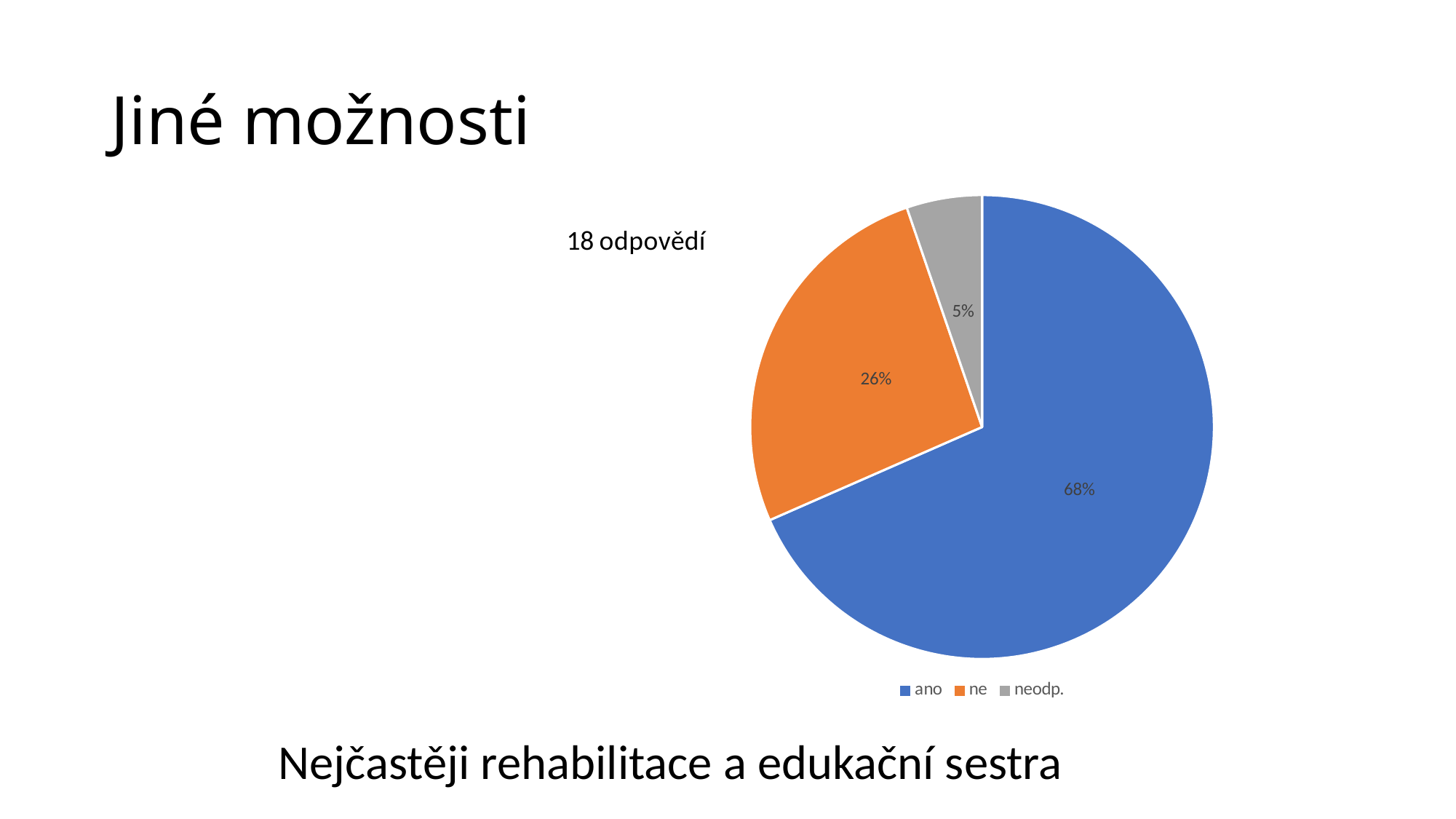
What share of the pie does the "ano" slice represent? 68% What is the difference in percentage points between the "ano" and "ne" slices? 42 What kind of chart is shown on the slide? pie chart Which slice is larger, "ne" or "neodp."? ne How many responses does the text next to the chart say were collected? 18 What colour is the "ne" slice in the pie chart? orange What is the difference in percentage points between the "ne" and "neodp." slices? 21 Which category has the largest slice of the pie? ano Which category has the smallest slice of the pie? neodp. How many categories does the pie chart show? 3 What share of the pie does the "ne" slice represent? 26% What share of the pie does the "neodp." slice represent? 5%